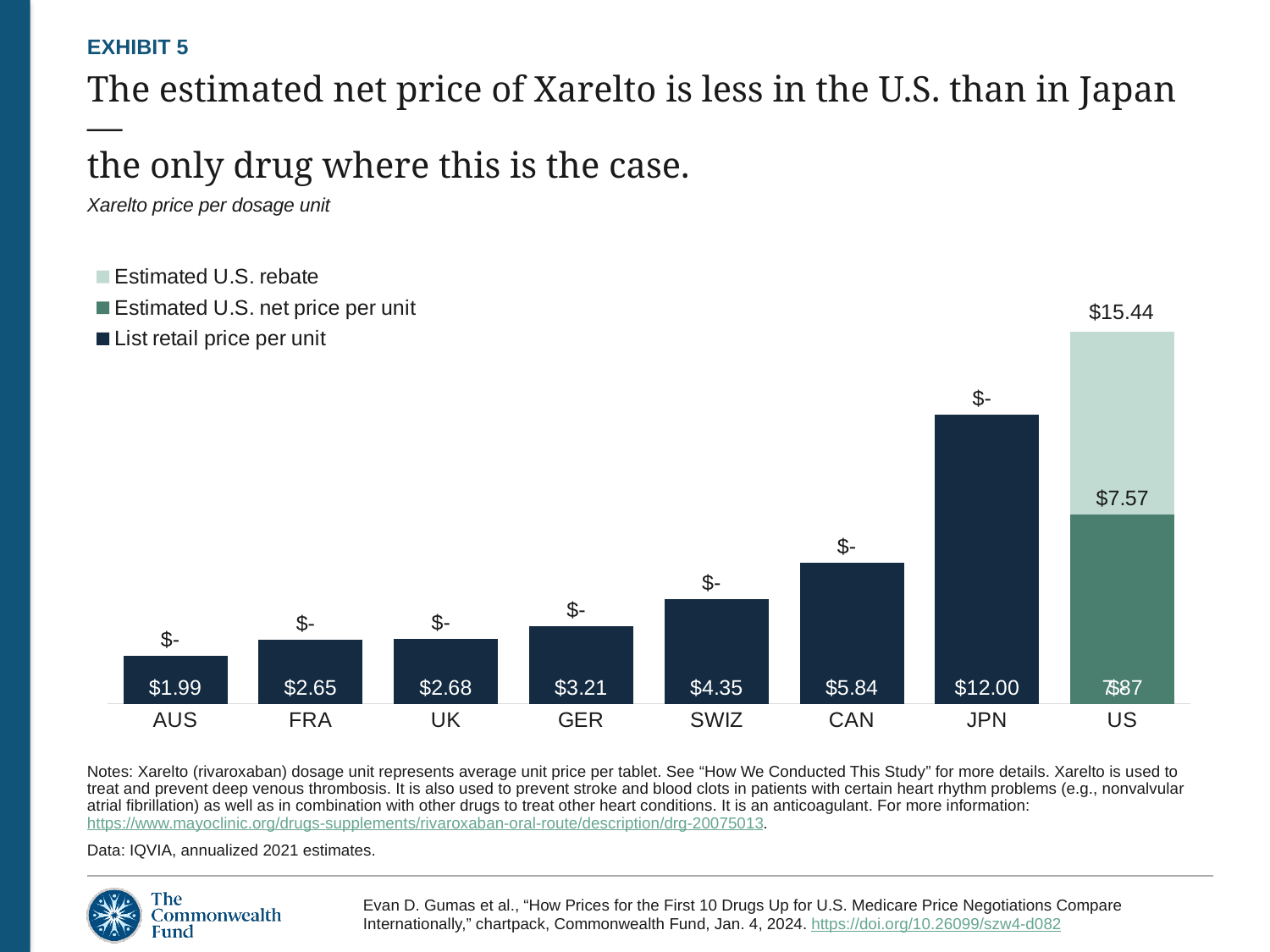
Which has a higher list retail price per unit, SWIZ or GER? SWIZ How many series does the legend list? 3 What kind of chart is shown on the slide? Bar chart What is the difference between the list retail price per unit in JPN and in CAN? $6.16 How many countries are shown on the x axis? 8 What is the list retail price per unit of Xarelto in JPN? $12.00 What value is labeled at the top of the US bar? $15.44 Which country has the lowest list retail price per unit? AUS Which country has the tallest bar in the chart? US What is the list retail price per unit of Xarelto in AUS? $1.99 What is the list retail price per unit of Xarelto in CAN? $5.84 What is the estimated U.S. net price per unit of Xarelto? $7.87